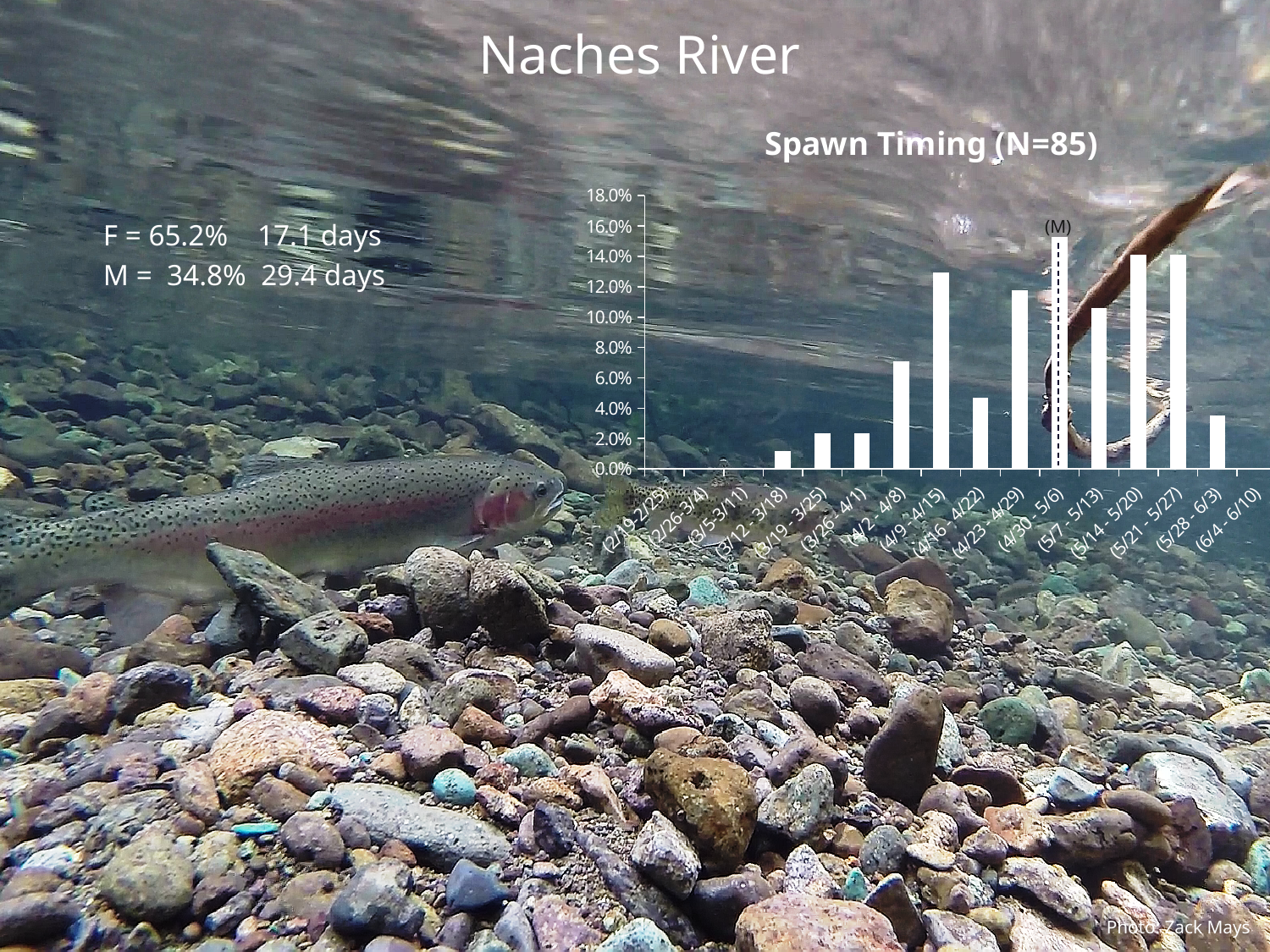
How many date-range categories are shown on the x axis of the chart? 16 Is the value for (4/16 - 4/22) greater or less than 6.0%? less Above which date range's bar is the label "(M)" placed? (4/30 - 5/6) Which is larger, the value for (4/9 - 4/15) or the value for (4/23 - 4/29)? (4/9 - 4/15) Is the value for (4/2 - 4/8) greater or less than 8.0%? less Is the value for (4/9 - 4/15) greater or less than 12.0%? greater Which date range has the highest bar in the chart? (4/30 - 5/6) Which is larger, the value for (4/2 - 4/8) or the value for (4/16 - 4/22)? (4/2 - 4/8) What is the title of the chart? Spawn Timing (N=85) What kind of chart is shown on the slide? bar chart